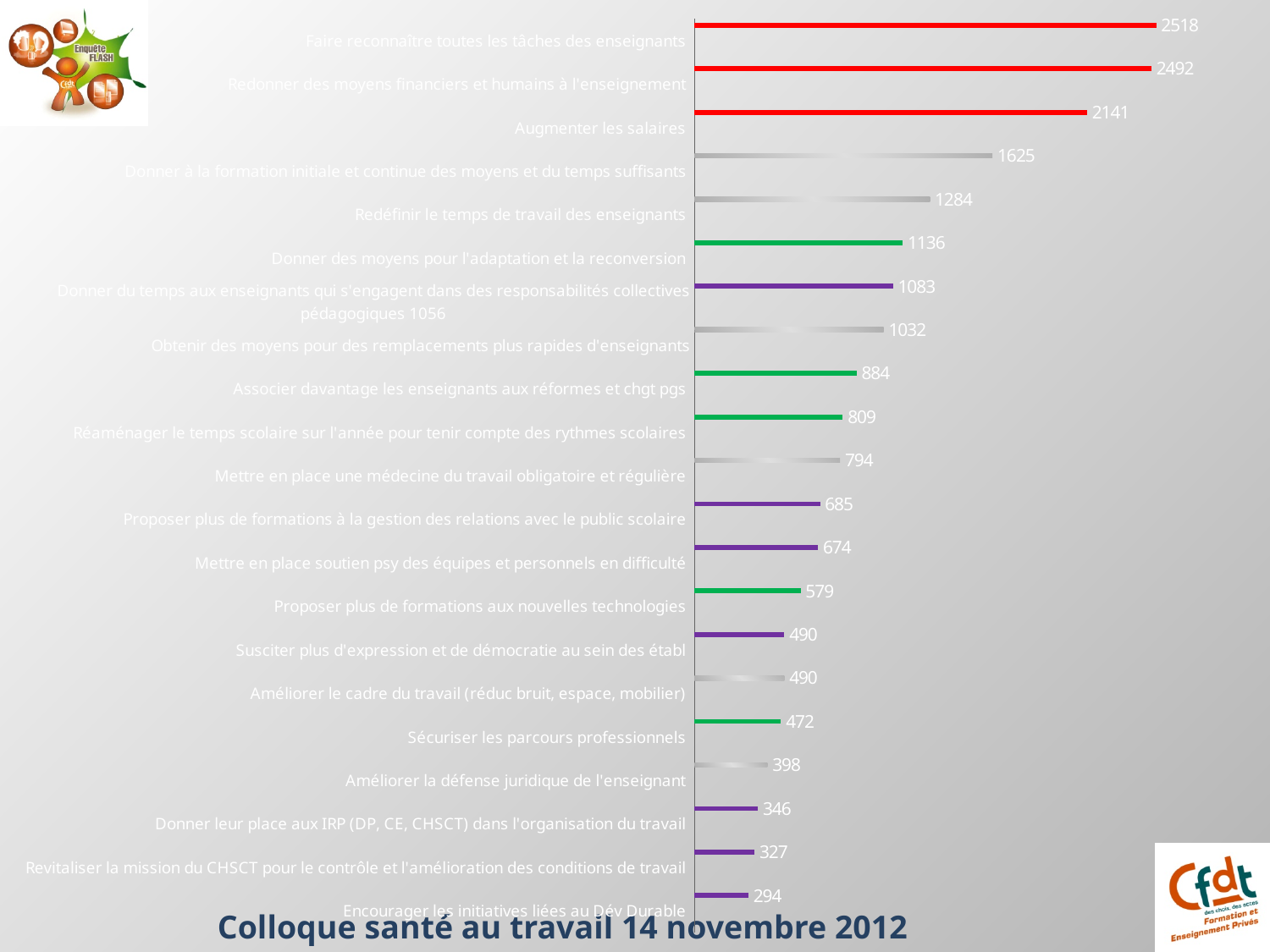
What is the value for "Augmenter les salaires"? 2141 What is the value for "Sécuriser les parcours professionnels"? 472 Which category has the highest value? Faire reconnaître toutes les tâches des enseignants What is the difference between the values for "Faire reconnaître toutes les tâches des enseignants" and "Augmenter les salaires"? 377 What colour are the bars for the three highest values? Red What kind of chart is shown on the slide? Bar chart What is the difference between the values for "Donner des moyens pour l'adaptation et la reconversion" and "Obtenir des moyens pour des remplacements plus rapides d'enseignants"? 104 Which is larger: the value for "Proposer plus de formations aux nouvelles technologies" or the value for "Améliorer la défense juridique de l'enseignant"? Proposer plus de formations aux nouvelles technologies Which category has the lowest value? Encourager les initiatives liées au Dév Durable What is the value for "Mettre en place une médecine du travail obligatoire et régulière"? 794 What is the value for "Redéfinir le temps de travail des enseignants"? 1284 How many categories are shown in the chart? 21